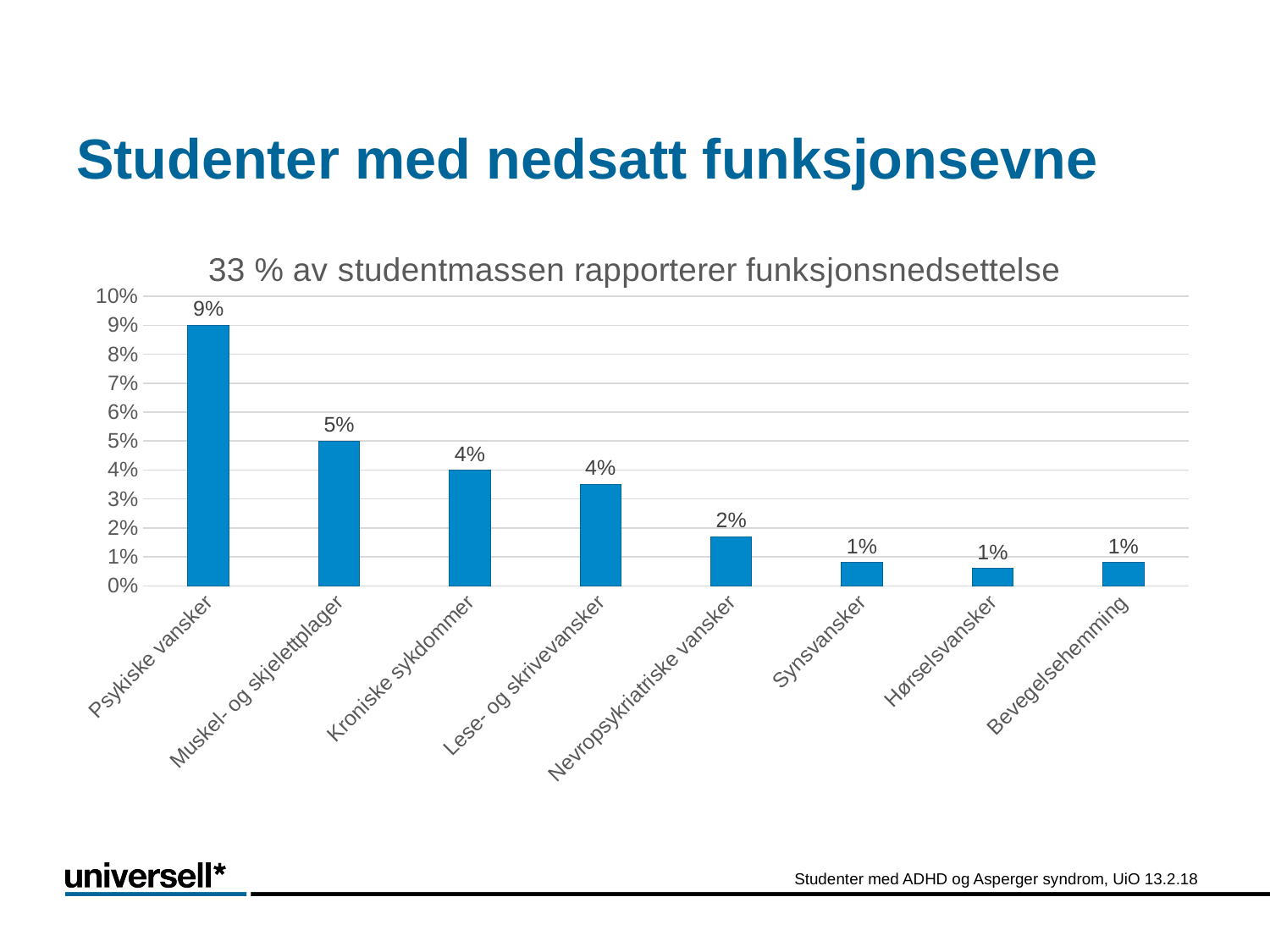
How many categories are shown on the x axis? 8 What is the difference between the values for Psykiske vansker and Muskel- og skjelettplager? 4 percentage points What is the value for Muskel- og skjelettplager? 5% Which is larger, the value for Muskel- og skjelettplager or the value for Nevropsykiatriske vansker? Muskel- og skjelettplager What is the title of the chart? 33 % av studentmassen rapporterer funksjonsnedsettelse What is the value for Psykiske vansker? 9% Which category has the highest value? Psykiske vansker What is the value for Nevropsykiatriske vansker? 2% What is the value for Kroniske sykdommer? 4% What kind of chart is shown on the slide? bar chart Do the values rise or fall from left to right along the x axis? fall Is the value for Nevropsykiatriske vansker greater or less than 3%? less